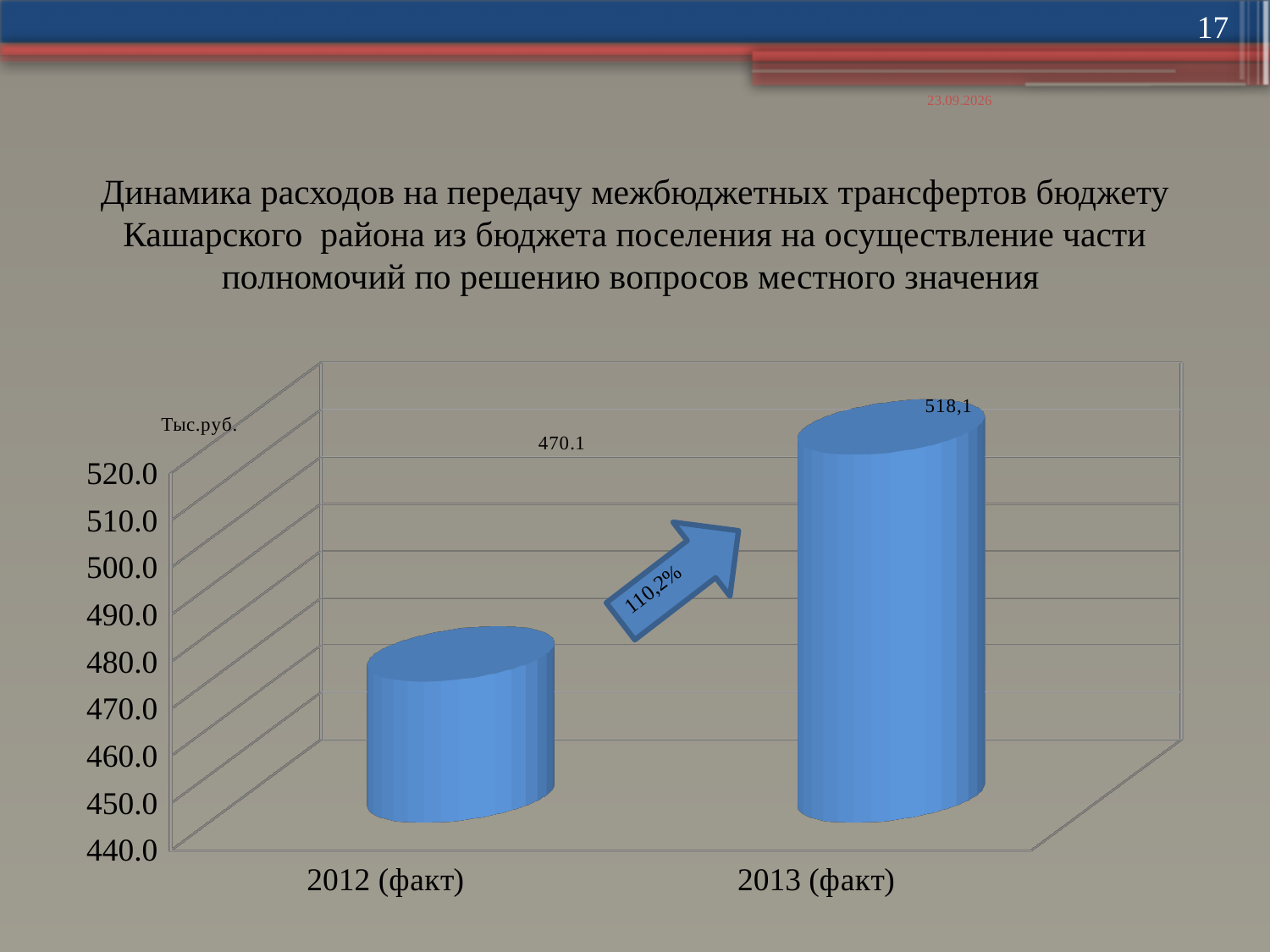
Which category has the highest value? 2013 (факт) Is the value for 2013 (факт) greater or less than 500.0? greater Do the values rise or fall from 2012 (факт) to 2013 (факт)? rise Which category has the lowest value? 2012 (факт) By how much does the value for 2013 (факт) exceed the value for 2012 (факт)? 48.0 What percentage is written on the arrow between the two bars? 110,2% What is the value for 2012 (факт)? 470.1 How many categories are shown on the x axis? 2 What kind of chart is shown on the slide? bar chart What is the value for 2013 (факт)? 518,1 Which is larger, the value for 2012 (факт) or 2013 (факт)? 2013 (факт) Is the value for 2012 (факт) greater or less than 480.0? less